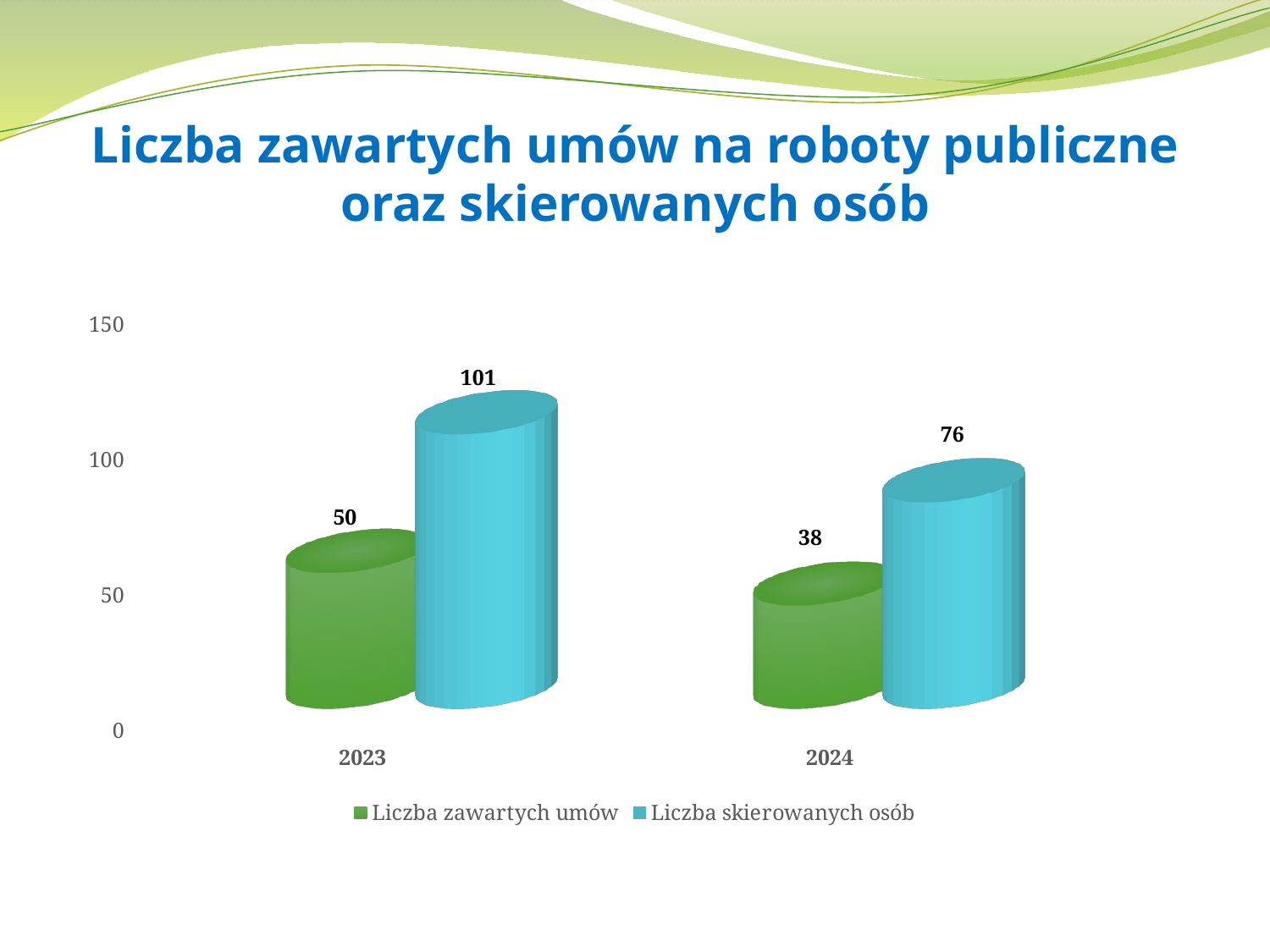
What is the difference between Liczba skierowanych osób in 2023 and in 2024? 25 What is the difference between Liczba zawartych umów in 2023 and in 2024? 12 What kind of chart is shown on the slide? Bar chart What is the value of Liczba zawartych umów for 2023? 50 What is the value of Liczba zawartych umów for 2024? 38 What is the value of Liczba skierowanych osób for 2024? 76 Do the values for Liczba skierowanych osób rise or fall from 2023 to 2024? Fall What is the value of Liczba skierowanych osób for 2023? 101 How many series does the legend list? 2 Which year has the highest value for Liczba skierowanych osób? 2023 Which year has the lowest value for Liczba zawartych umów? 2024 Which is larger in 2024: Liczba zawartych umów or Liczba skierowanych osób? Liczba skierowanych osób